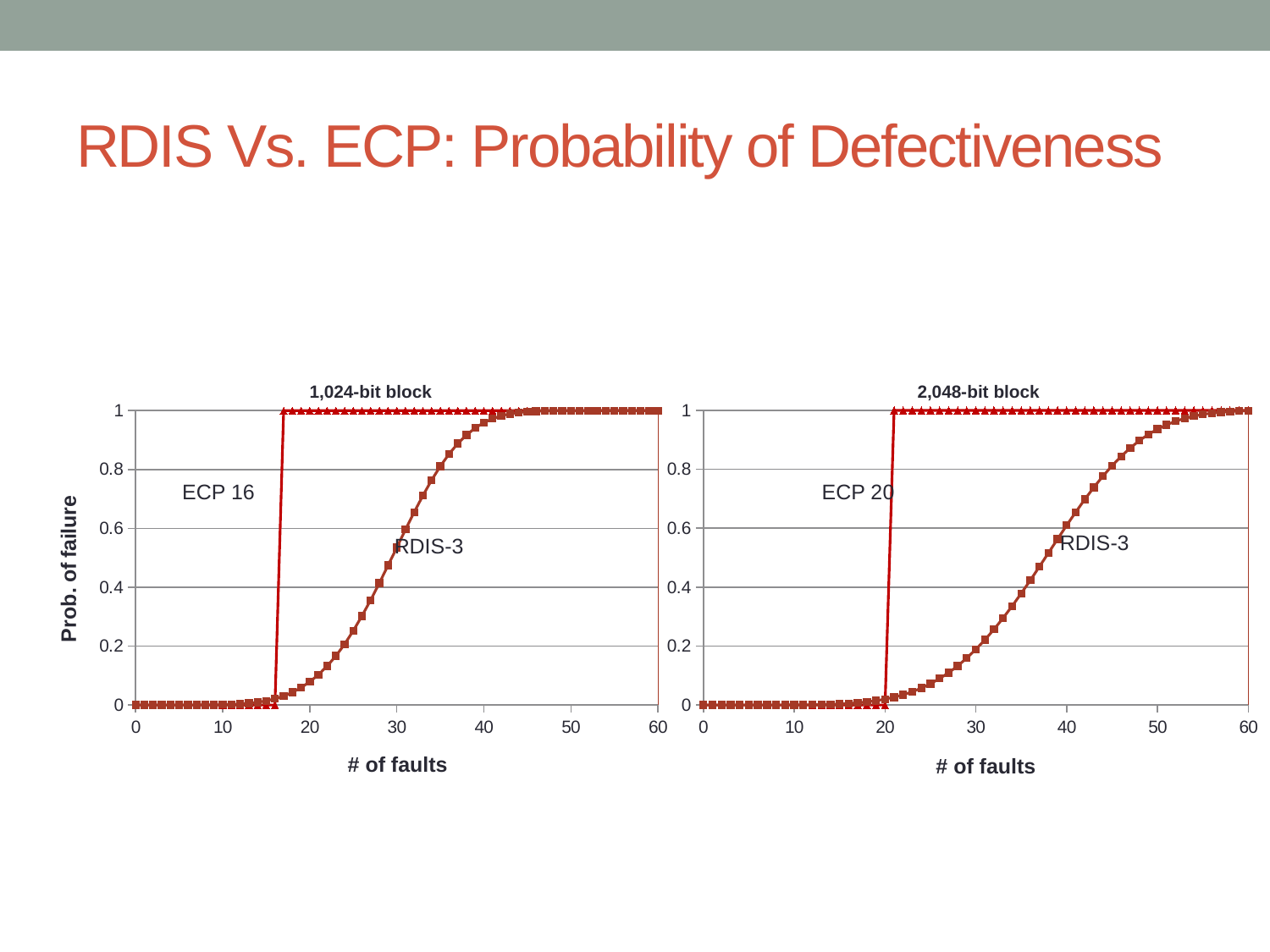
In the "1,024-bit block" chart, is the RDIS-3 value at 40 faults greater or less than 0.8? greater In the "2,048-bit block" chart, does the RDIS-3 probability of failure rise or fall as the number of faults increases? rise In the "1,024-bit block" chart, is the ECP 16 value at 10 faults greater or less than 0.2? less What kind of chart is the "1,024-bit block" chart? line chart In the "1,024-bit block" chart, how many series are plotted? 2 In the "2,048-bit block" chart, is the ECP 20 value at 30 faults greater or less than 0.8? greater How many charts are shown on the slide? 2 In the "2,048-bit block" chart, what are the two series labelled? ECP 20 and RDIS-3 In the "1,024-bit block" chart, at 30 faults, which series has the higher probability of failure, ECP 16 or RDIS-3? ECP 16 What is the x-axis label of the "1,024-bit block" chart? # of faults